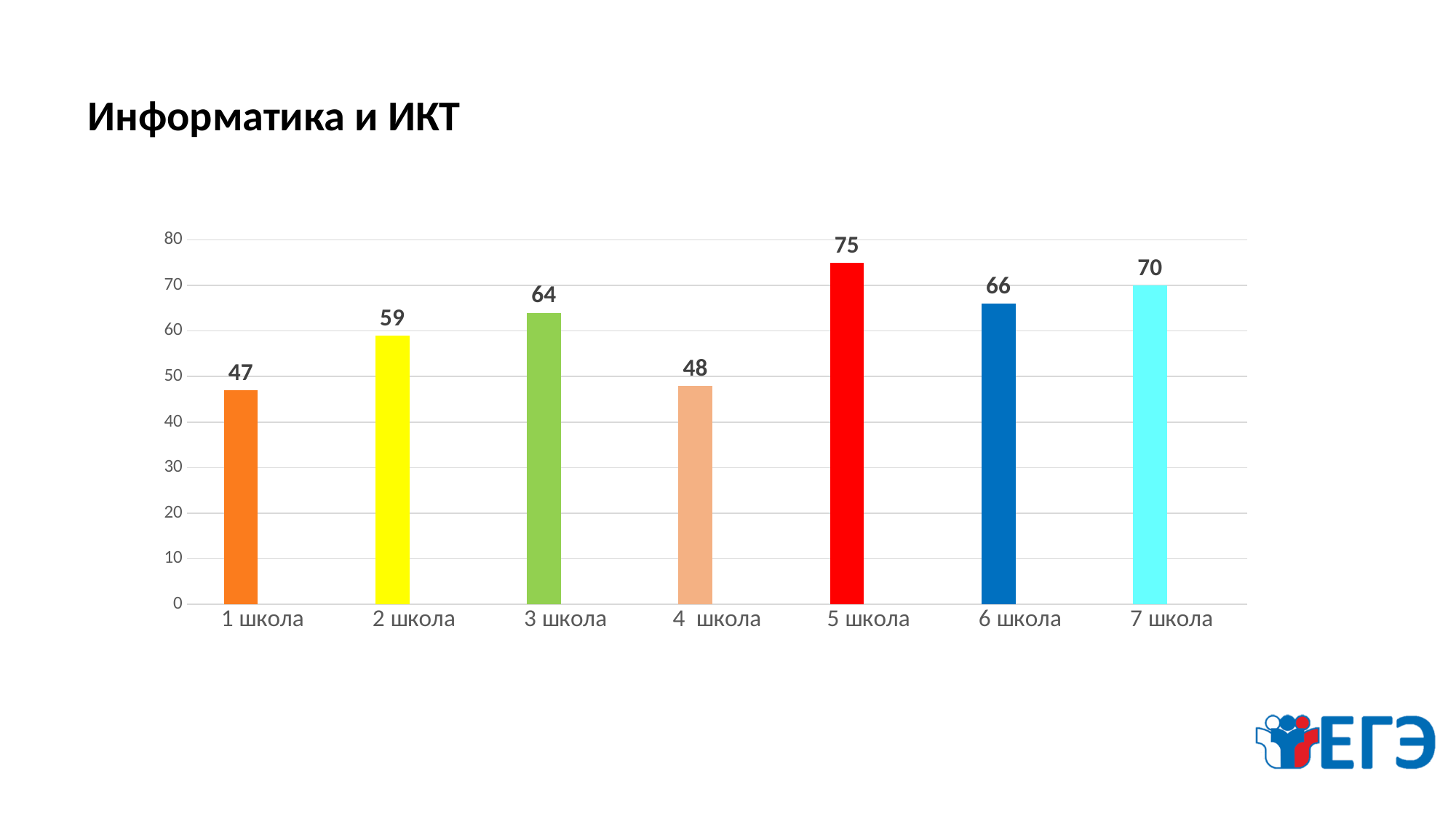
Is the value for 4 школа greater or less than 50? less Which is larger, the value for 6 школа or the value for 7 школа? 7 школа What is the value for 5 школа? 75 What is the value for 7 школа? 70 What is the difference between the values for 3 школа and 2 школа? 5 What is the title of the slide? Информатика и ИКТ What is the value for 1 школа? 47 How many schools are shown on the chart? 7 Which school has the highest value? 5 школа What kind of chart is shown on the slide? bar chart Which school has the lowest value? 1 школа What is the difference between the values for 5 школа and 1 школа? 28